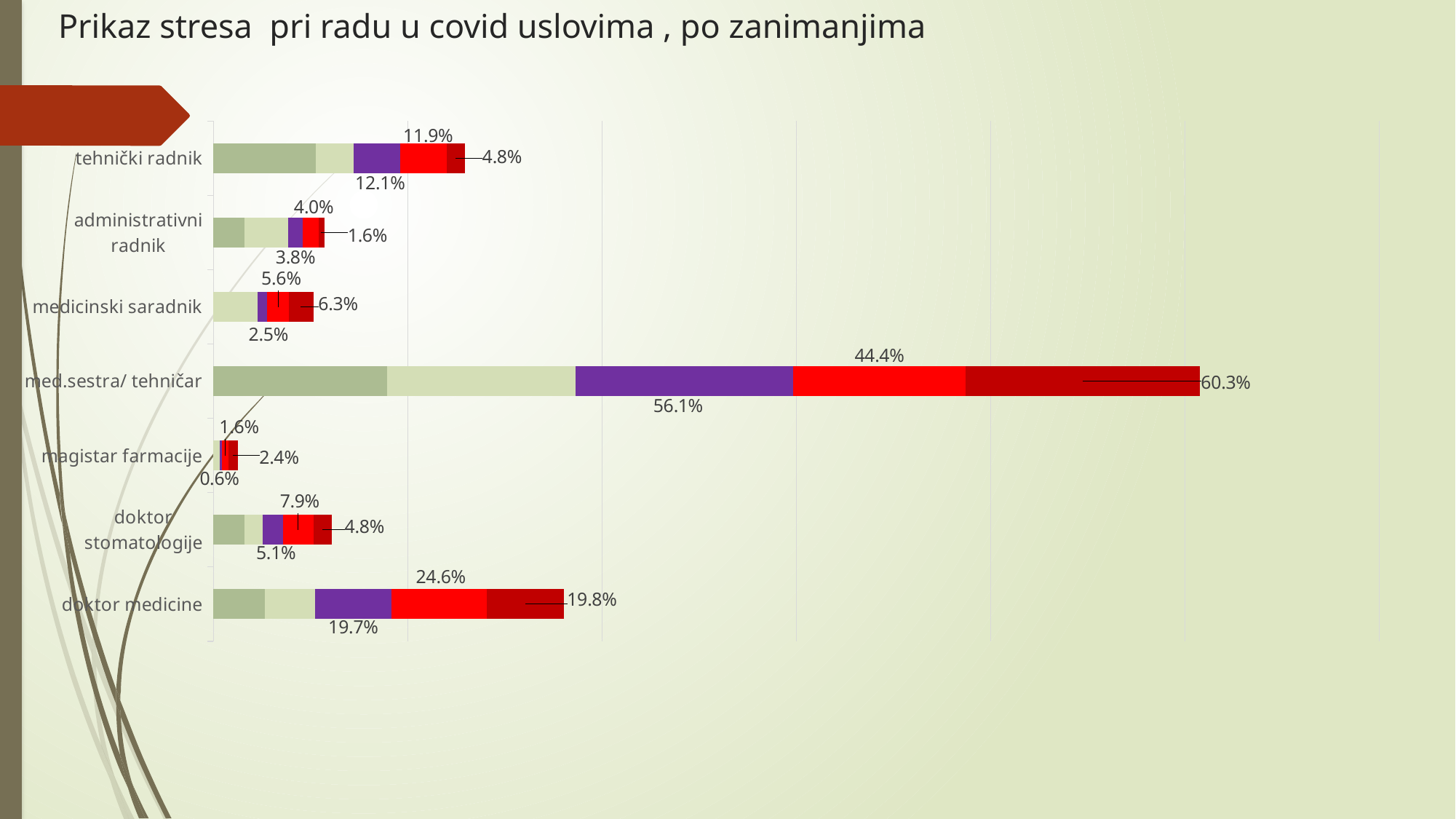
Which has the larger value labelled at the end of its bar: doktor medicine or doktor stomatologije? doktor medicine What value is labelled below the bar for magistar farmacije? 0.6% What value is labelled at the end of the bar for med.sestra/ tehničar? 60.3% What is the difference between the end-of-bar values for med.sestra/ tehničar (60.3%) and doktor medicine (19.8%)? 40.5% How many occupation categories are shown on the chart? 7 What is the title of the slide? Prikaz stresa pri radu u covid uslovima , po zanimanjima Which occupation has the shortest bar on the chart? magistar farmacije What value is labelled above the bar for tehnički radnik? 11.9% What value is labelled above the bar for doktor medicine? 24.6% What value is labelled at the end of the bar for doktor medicine? 19.8% Which occupation has the longest bar on the chart? med.sestra/ tehničar What kind of chart is shown on the slide? bar chart